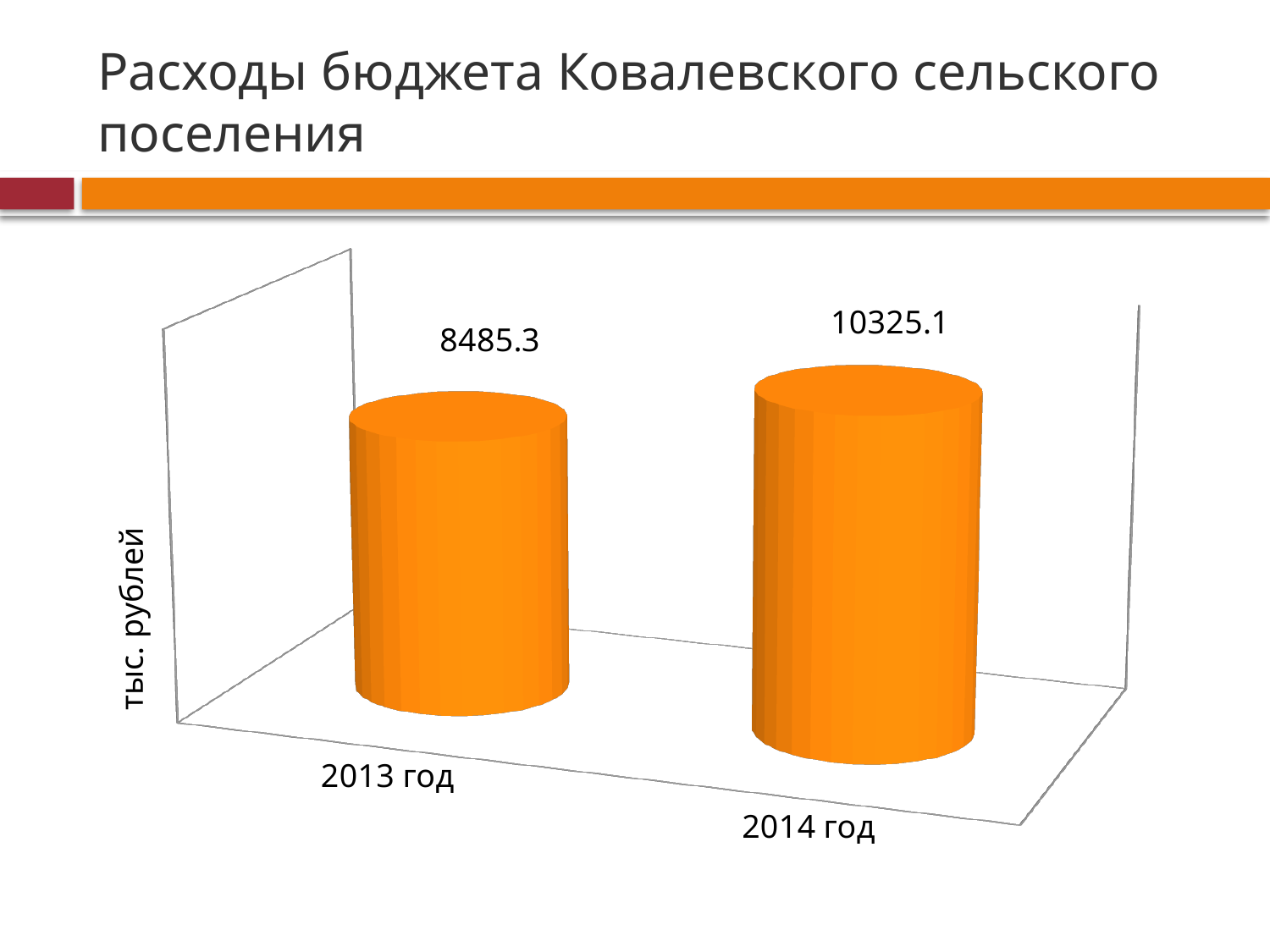
Which year has the lowest value? 2013 год What colour are the bars in the chart? orange Do the values rise or fall from 2013 год to 2014 год? rise What is the label of the vertical axis? тыс. рублей How many categories are shown in the chart? 2 Which is larger, the value for 2013 год or 2014 год? 2014 год What is the value for 2013 год? 8485.3 What is the difference between the values for 2014 год and 2013 год? 1839.8 Which year has the highest value? 2014 год What kind of chart is shown on the slide? bar chart What is the value for 2014 год? 10325.1